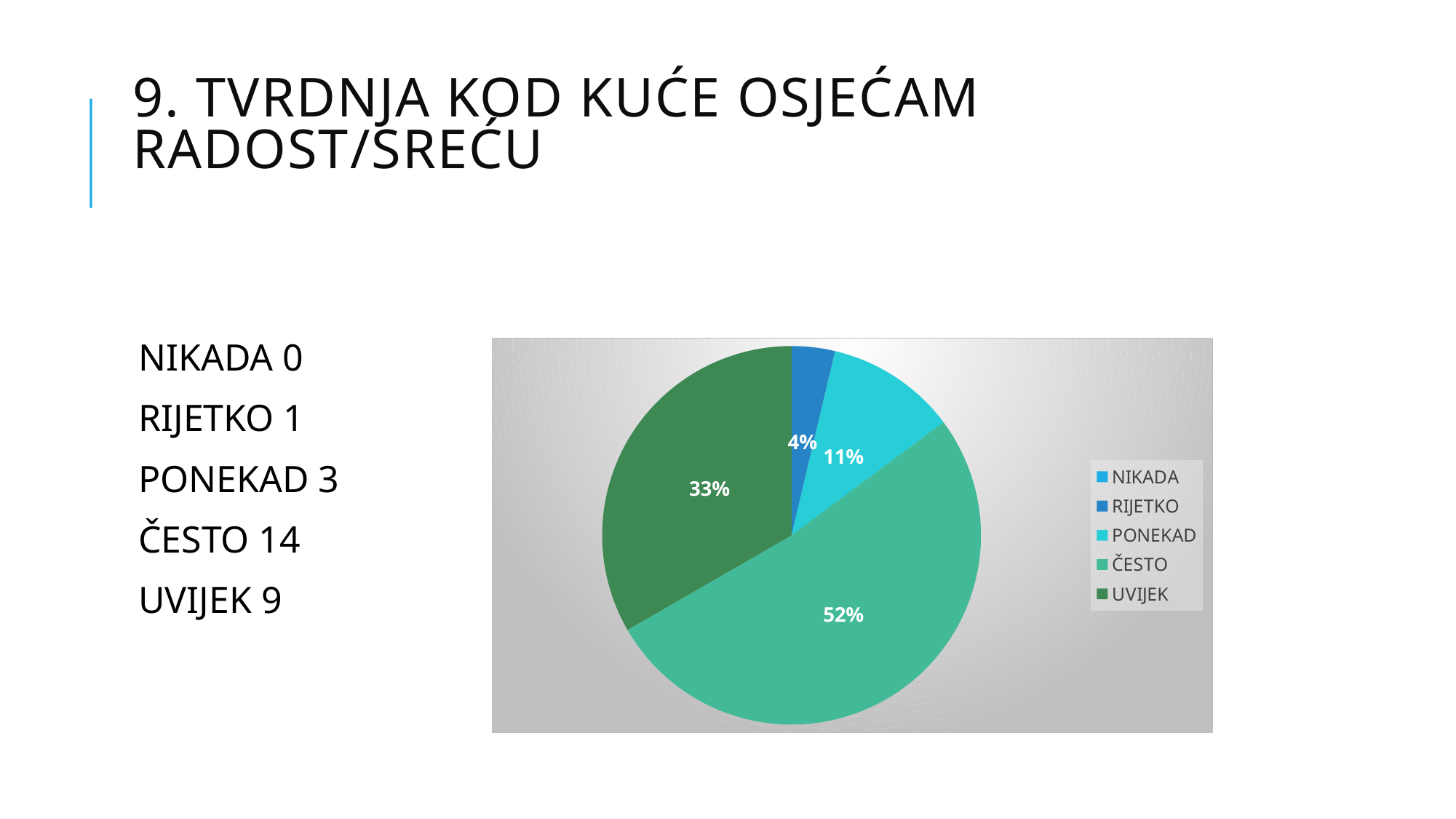
Which legend entry has no visible slice in the pie chart? NIKADA What kind of chart is shown on the slide? pie chart Which category has the largest slice in the pie chart? ČESTO Which category with a visible slice has the smallest share in the pie chart? RIJETKO What percentage share does the UVIJEK slice have in the pie chart? 33% What percentage share does the PONEKAD slice have in the pie chart? 11% Which slice is larger, PONEKAD or UVIJEK? UVIJEK What colour is the ČESTO slice in the pie chart? green What percentage share does the RIJETKO slice have in the pie chart? 4% What percentage share does the ČESTO slice have in the pie chart? 52% What is the difference in percentage points between the ČESTO and UVIJEK slices? 19% How many entries does the legend of the pie chart list? 5